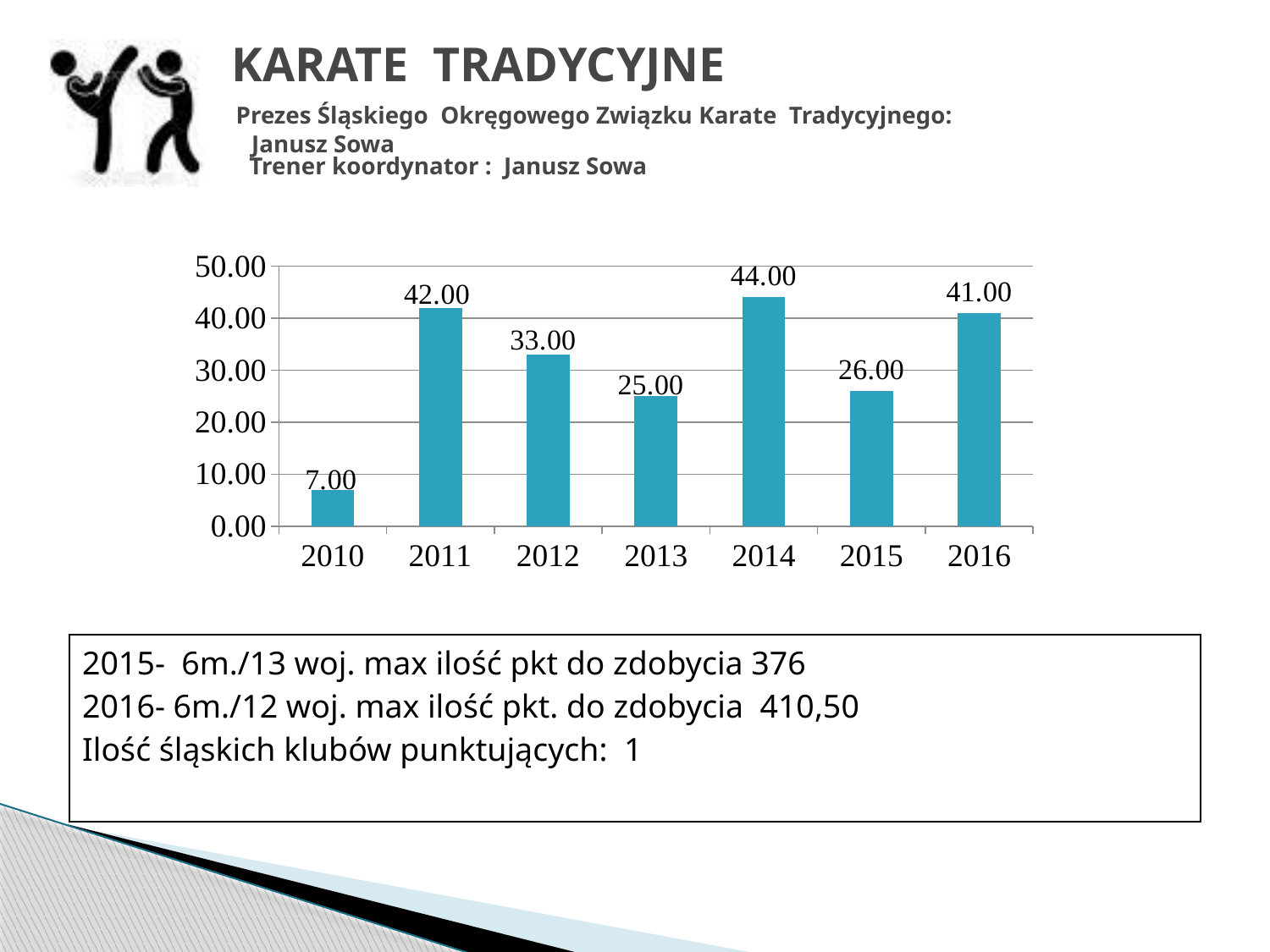
Do the values rise or fall from 2014 to 2015? fall Which is larger, the value for 2013 or the value for 2015? 2015 What kind of chart is shown on the slide? bar chart What is the difference between the values for 2014 and 2015? 18.00 Is the value for 2012 greater or less than 30.00? greater What is the value for 2010? 7.00 How many years are shown on the x axis? 7 What is the difference between the values for 2011 and 2012? 9.00 Which year has the lowest value? 2010 What is the value for 2016? 41.00 Which year has the highest value? 2014 What is the value for 2014? 44.00